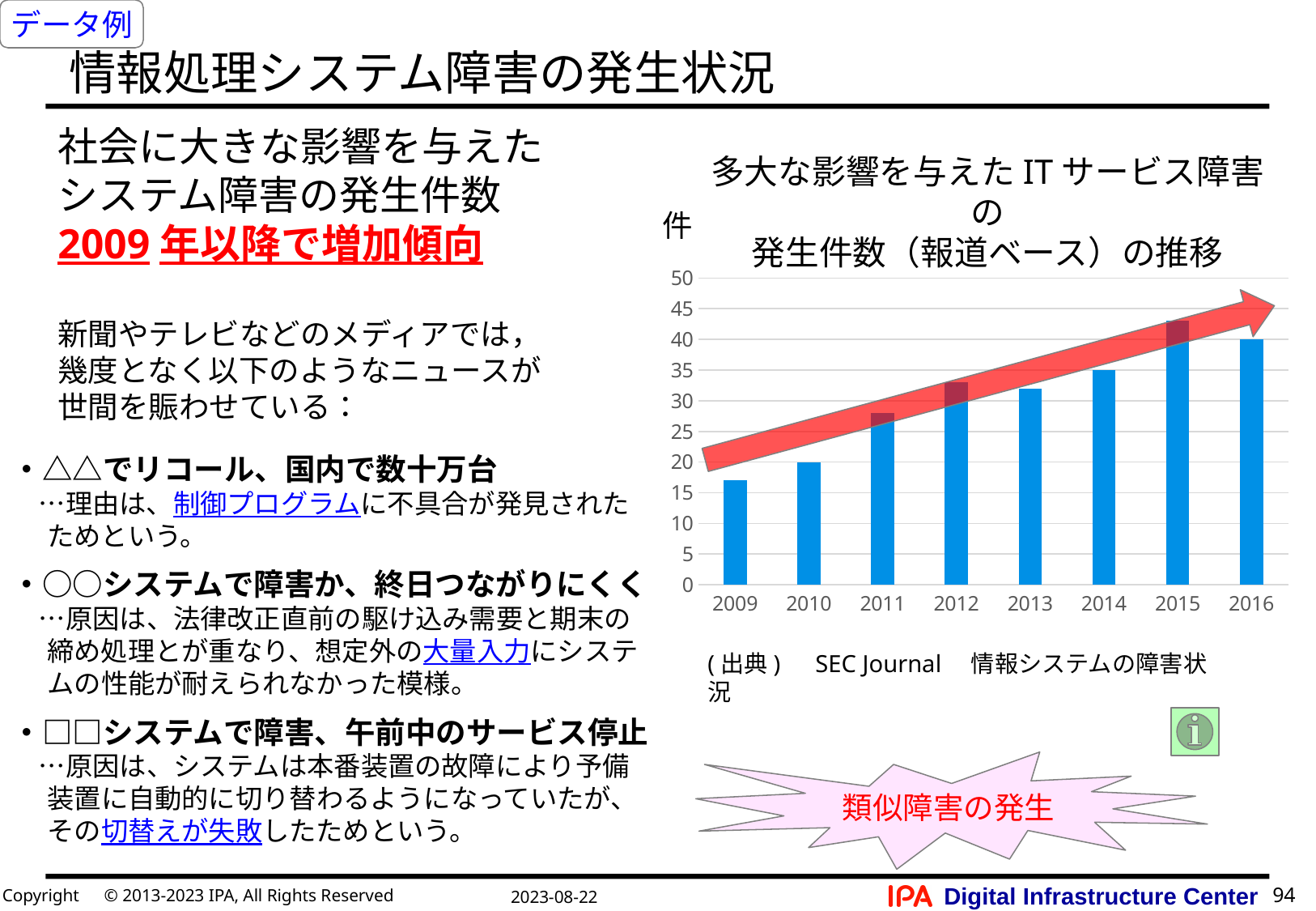
Which year has the larger value, 2011 or 2015? 2015 What kind of chart is shown on the slide? bar chart Do the values in the chart rise or fall from 2009 to 2016? rise Is the value for 2010 greater or less than 25? less Is the value for 2013 greater or less than 30? greater Is the value for 2016 greater or less than 35? greater What unit label is shown at the top of the chart's vertical axis? 件 Which year has the larger value, 2009 or 2013? 2013 How many years are shown on the x axis of the chart? 8 Which year has the lowest number of incidents in the chart? 2009